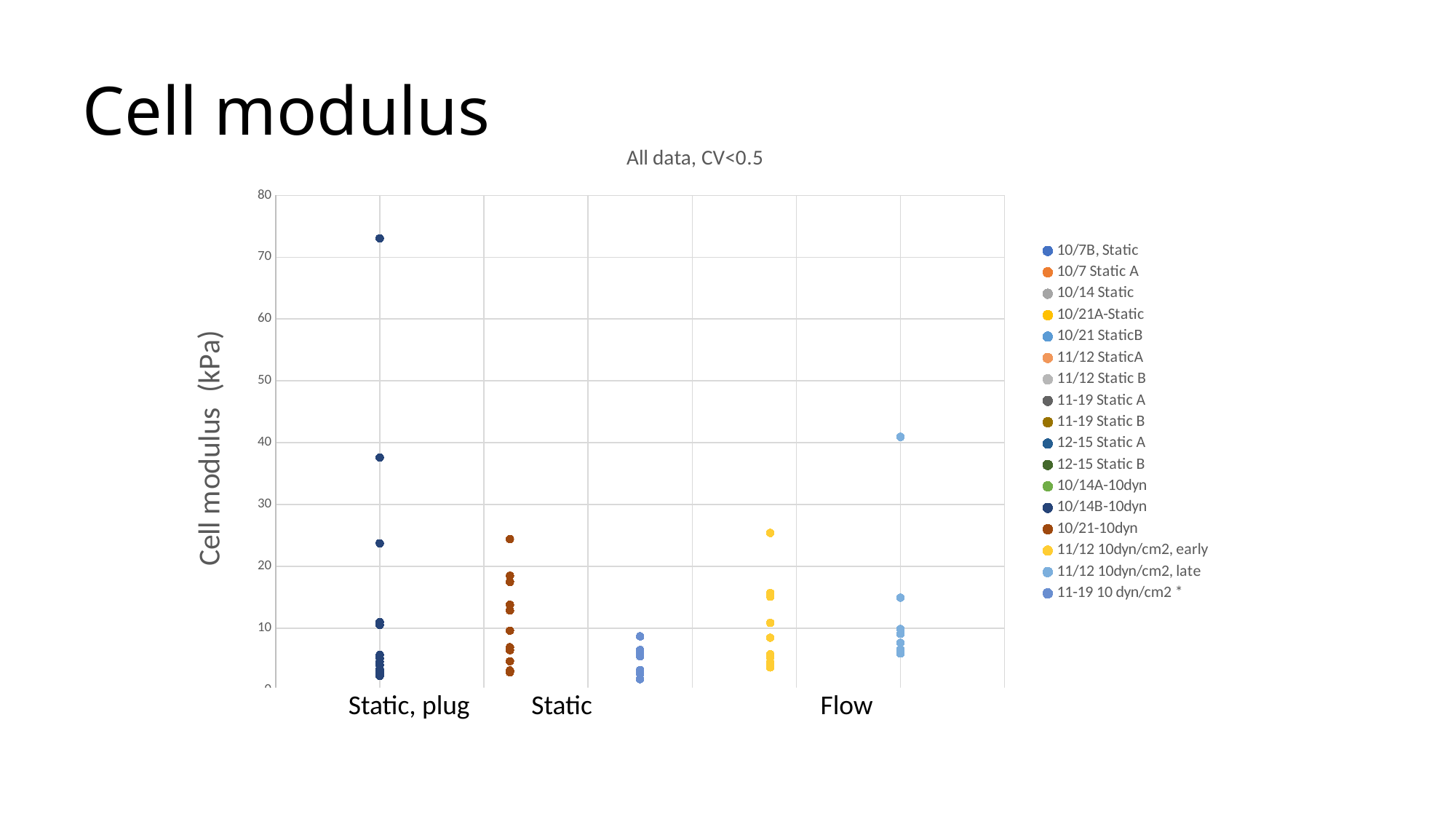
What is the maximum value shown on the y axis? 80 Which group contains the single highest point on the chart? Static, plug How many entries does the legend list? 17 How many group labels are shown along the x axis? 3 What kind of chart is shown on the slide? Scatter chart Is the highest point in the "Flow" group greater or less than 50? less Is the highest point in the "Static, plug" group greater or less than 70? greater Is the highest point in the "Flow" group greater or less than 30? greater What is the label of the y axis? Cell modulus (kPa) What is the title of the chart? All data, CV<0.5 Which has a higher maximum point: the "Static, plug" group or the "Static" group? Static, plug